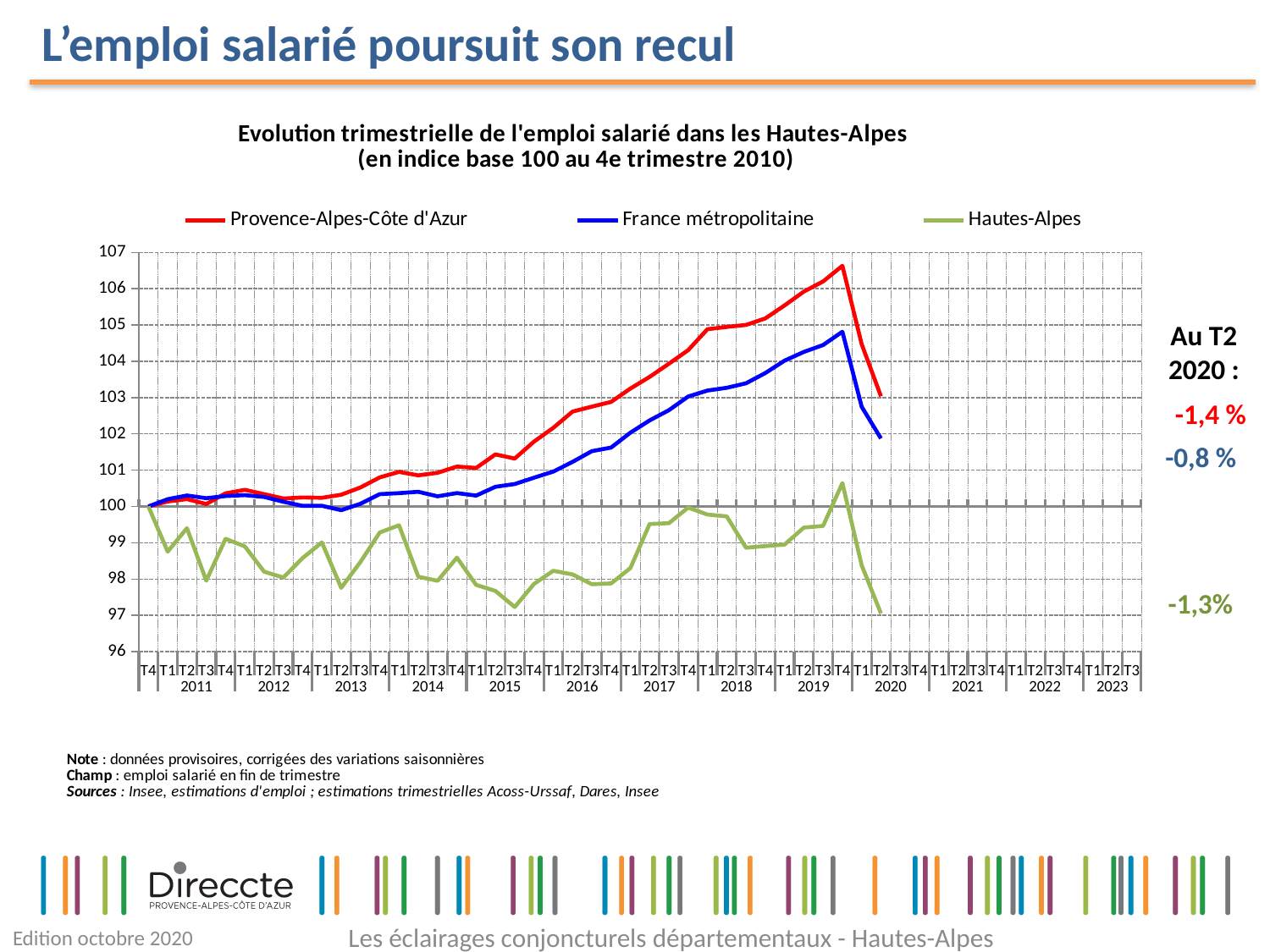
At T2 2020, which is larger: the value for France métropolitaine or the value for Hautes-Alpes? France métropolitaine According to the annotation on the right, what is the change for Provence-Alpes-Côte d'Azur at T2 2020? -1,4 % How many series does the legend list? 3 Which series has the lowest value at T2 2020? Hautes-Alpes Is the value for Provence-Alpes-Côte d'Azur at T4 2019 greater or less than 106? greater Does the Hautes-Alpes line rise or fall between T4 2019 and T2 2020? fall Is the value for Hautes-Alpes at T2 2020 greater or less than 98? less Does the Provence-Alpes-Côte d'Azur line rise or fall between T1 2013 and T4 2019? rise Which series is plotted in green? Hautes-Alpes What kind of chart is shown on the slide? line chart Is the value for France métropolitaine at T2 2020 greater or less than 103? less Which series has the highest value at T4 2019? Provence-Alpes-Côte d'Azur